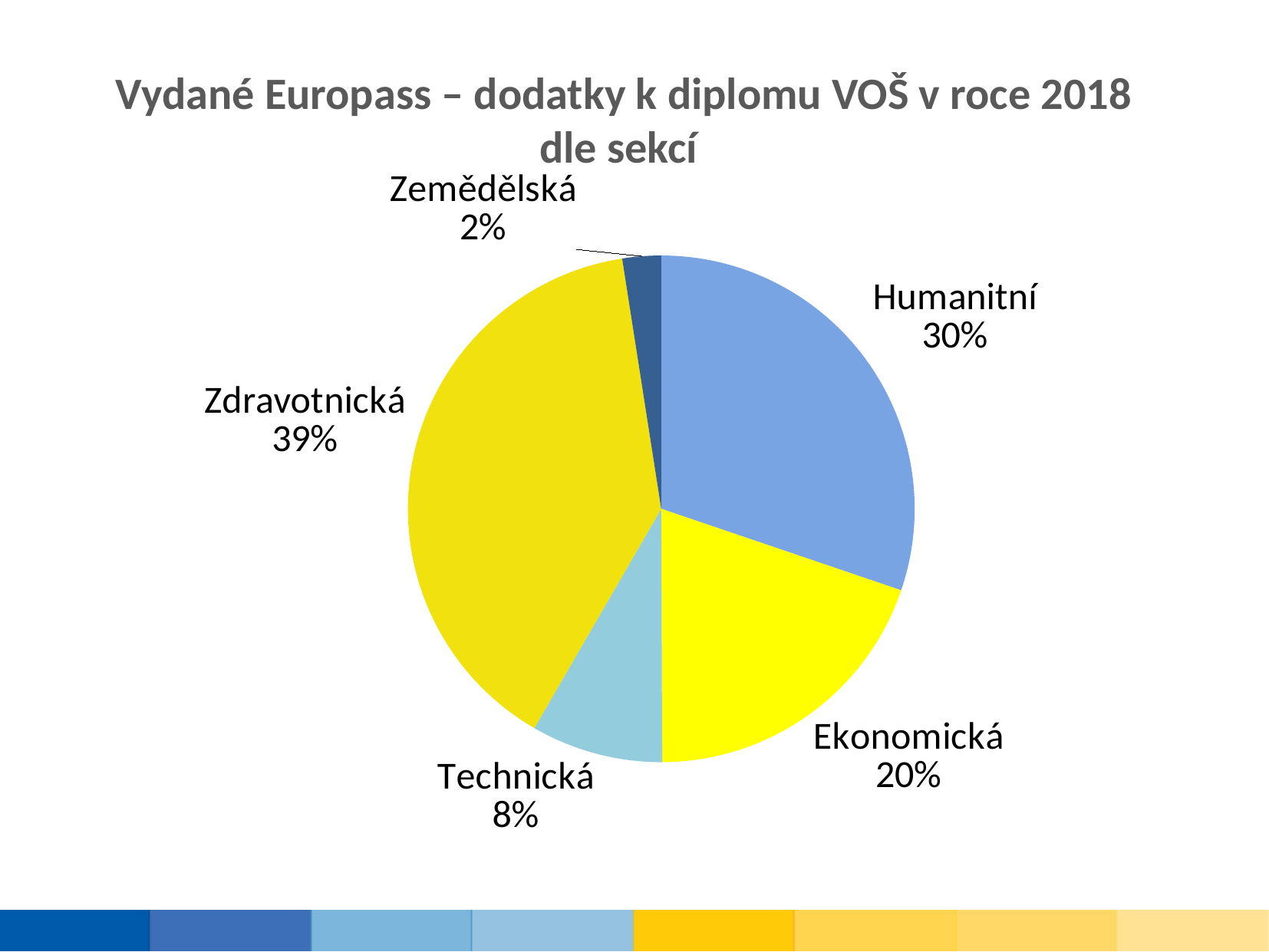
Which is larger, the share for Ekonomická or the share for Technická? Ekonomická What is the value shown for Zemědělská? 2% Which section has the largest share of the pie? Zdravotnická What is the value shown for Ekonomická? 20% What kind of chart is shown on the slide? Pie chart What share of the pie does Zdravotnická have? 39% How many sections are shown in the pie chart? 5 What is the title of the chart? Vydané Europass – dodatky k diplomu VOŠ v roce 2018 dle sekcí What is the value shown for Humanitní? 30% What is the value shown for Technická? 8% What is the difference between the shares of Zdravotnická and Humanitní? 9% Which section has the smallest share of the pie? Zemědělská